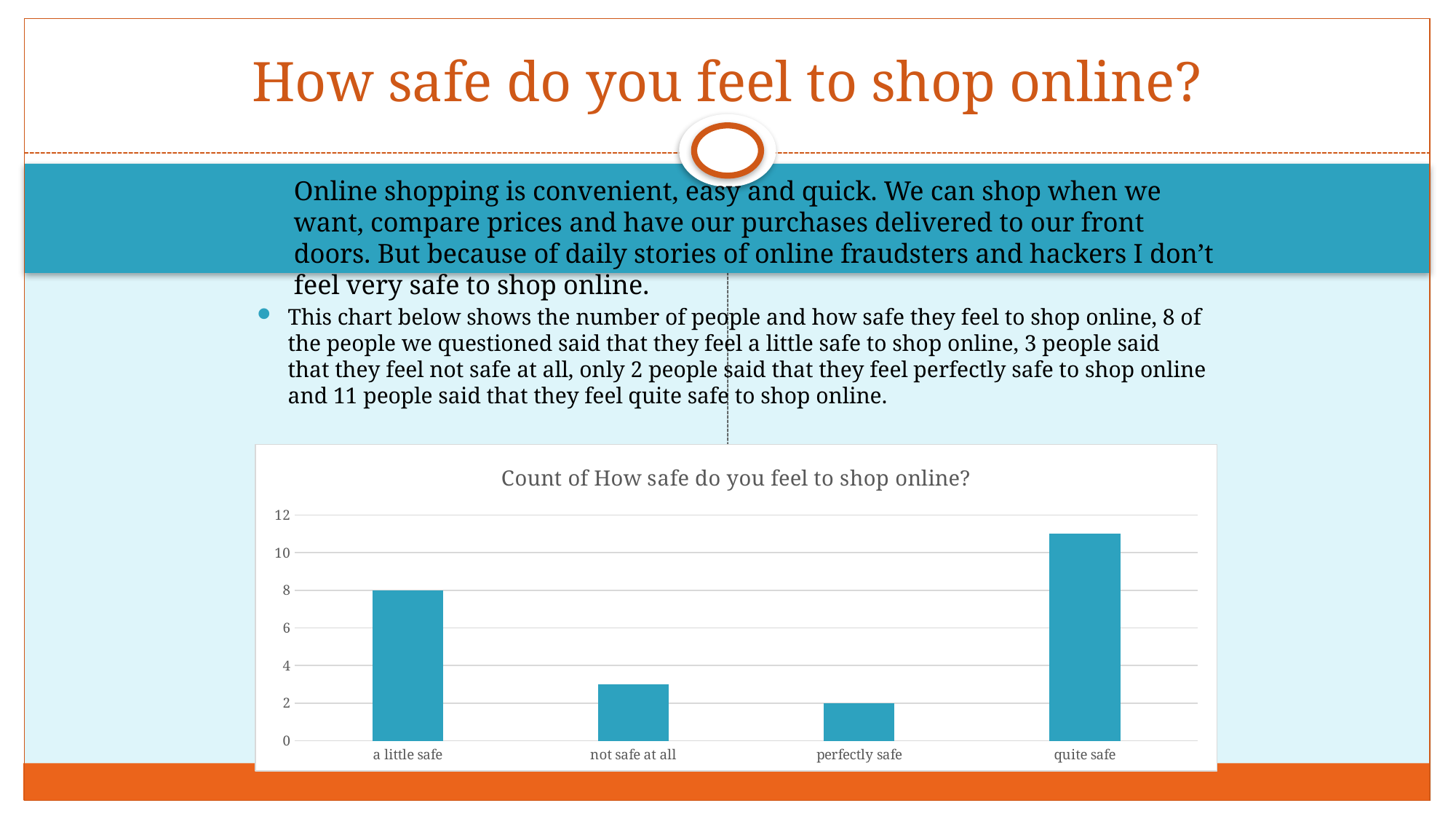
What is the count for 'not safe at all'? 3 Which category has the highest count? quite safe What is the count for 'quite safe'? 11 What type of chart is shown on the slide? bar chart What is the count for 'perfectly safe'? 2 How many categories are shown on the x axis of the chart? 4 Is the value for 'quite safe' greater or less than 10? greater What is the title of the chart? Count of How safe do you feel to shop online? What is the difference between the counts for 'quite safe' and 'a little safe'? 3 Which category has the lowest count? perfectly safe Which has a larger count, 'a little safe' or 'not safe at all'? a little safe What is the count for 'a little safe'? 8